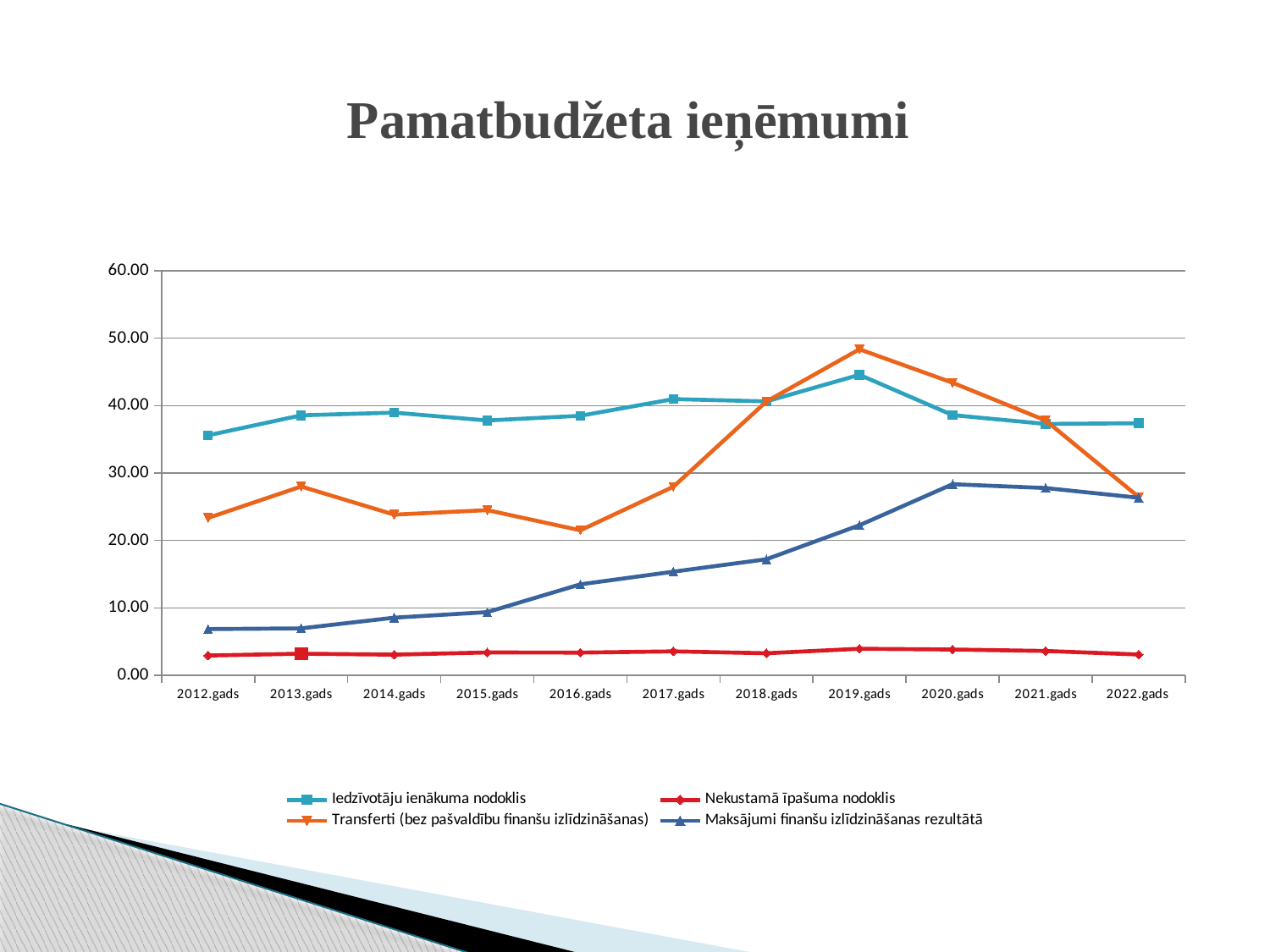
Is the value for Transferti (bez pašvaldību finanšu izlīdzināšanas) in 2019.gads greater or less than 40.00? greater In which year does Transferti (bez pašvaldību finanšu izlīdzināšanas) reach its highest value? 2019.gads How many series does the legend list? 4 What is the title of the chart? Pamatbudžeta ieņēmumi In which year does Transferti (bez pašvaldību finanšu izlīdzināšanas) reach its lowest value? 2016.gads Is the value for Maksājumi finanšu izlīdzināšanas rezultātā in 2012.gads greater or less than 10.00? less Does the value for Maksājumi finanšu izlīdzināšanas rezultātā rise or fall from 2012.gads to 2020.gads? rise In which year does Iedzīvotāju ienākuma nodoklis reach its highest value? 2019.gads How many years are plotted along the x axis? 11 In 2019.gads, which is larger: Transferti (bez pašvaldību finanšu izlīdzināšanas) or Iedzīvotāju ienākuma nodoklis? Transferti (bez pašvaldību finanšu izlīdzināšanas) What kind of chart is shown on the slide? line chart Is the value for Iedzīvotāju ienākuma nodoklis in 2012.gads greater or less than 30.00? greater